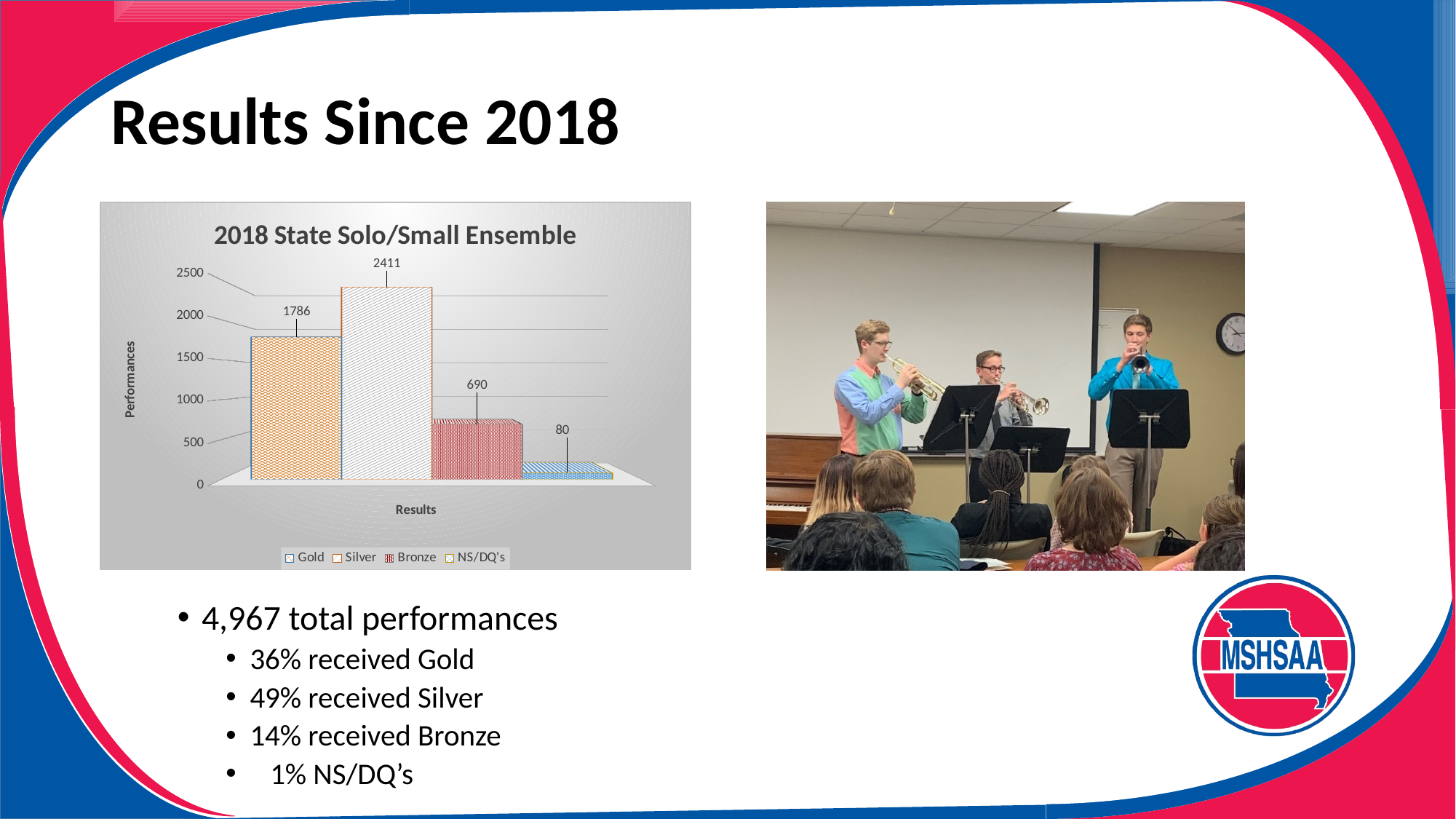
What is the label on the horizontal axis of the 2018 State Solo/Small Ensemble chart? Results What is the label on the vertical axis of the 2018 State Solo/Small Ensemble chart? Performances What kind of chart is the 2018 State Solo/Small Ensemble chart? Bar chart How many series does the legend of the 2018 State Solo/Small Ensemble chart list? 4 Which series has the highest value in the 2018 State Solo/Small Ensemble chart? Silver What is the value for NS/DQ's in the 2018 State Solo/Small Ensemble chart? 80 What is the difference between the Silver and Gold values in the 2018 State Solo/Small Ensemble chart? 625 Which is larger in the 2018 State Solo/Small Ensemble chart, Gold or Bronze? Gold What is the value for Silver in the 2018 State Solo/Small Ensemble chart? 2411 What is the value for Gold in the 2018 State Solo/Small Ensemble chart? 1786 Which series has the lowest value in the 2018 State Solo/Small Ensemble chart? NS/DQ's What is the value for Bronze in the 2018 State Solo/Small Ensemble chart? 690